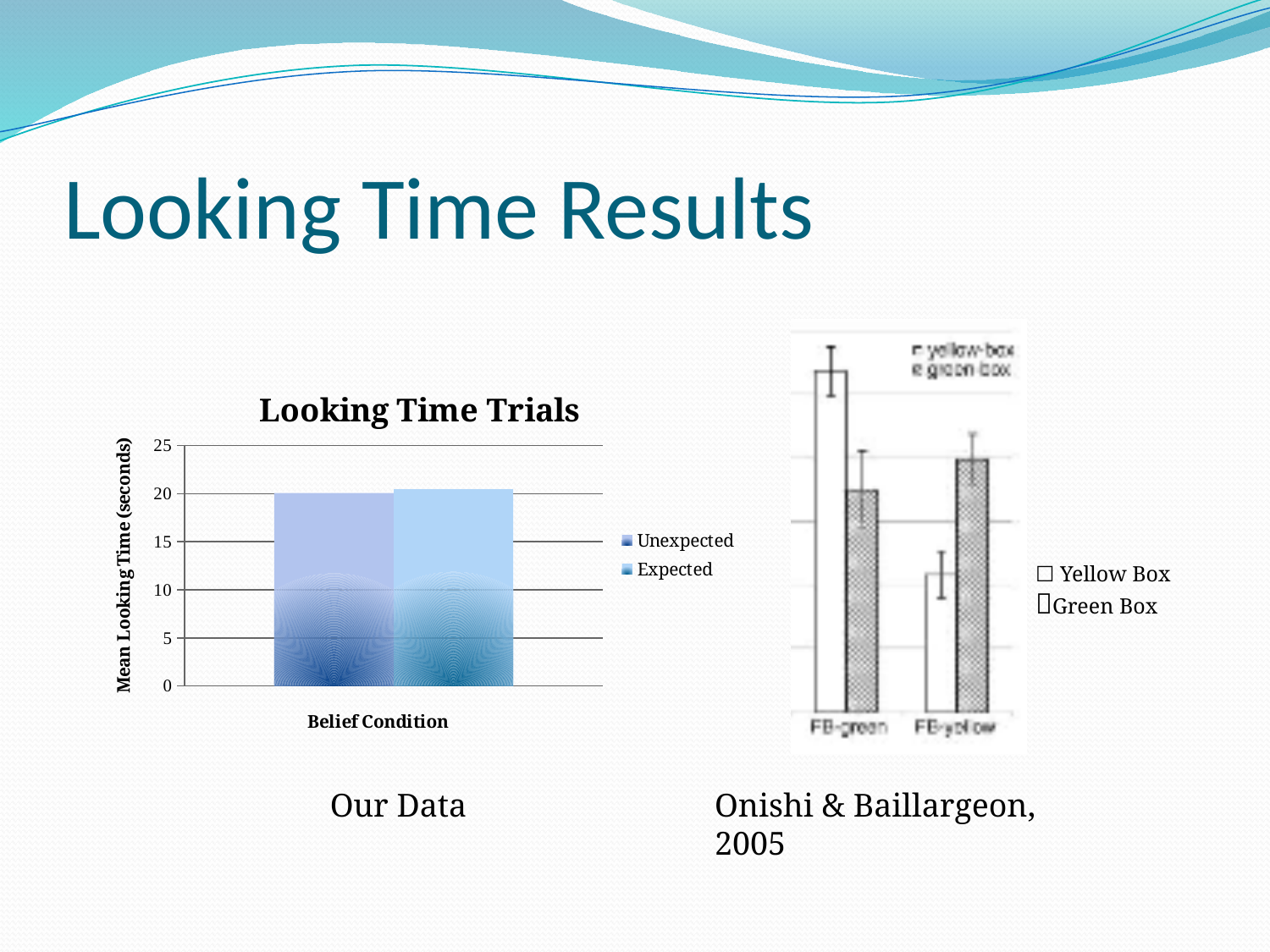
In the Onishi & Baillargeon, 2005 chart on the right, for the FB-yellow condition, which is larger: Yellow Box or Green Box? Green Box What type of chart is the "Looking Time Trials" chart on the left? bar chart In the Onishi & Baillargeon, 2005 chart on the right, which bar is the lowest? Yellow Box in FB-yellow In the Onishi & Baillargeon, 2005 chart on the right, which bar is the highest? Yellow Box in FB-green In the "Looking Time Trials" chart, is the value for Expected greater or less than 25? less What is the y-axis label of the "Looking Time Trials" chart? Mean Looking Time (seconds) In the "Looking Time Trials" chart, is the value for Unexpected greater or less than 15? greater How many series does the legend of the "Looking Time Trials" chart list? 2 In the Onishi & Baillargeon, 2005 chart on the right, how many categories are shown on the x axis? 2 What is the x-axis label of the "Looking Time Trials" chart? Belief Condition What are the two series named in the legend of the "Looking Time Trials" chart? Unexpected and Expected In the Onishi & Baillargeon, 2005 chart on the right, how many series does the legend list? 2